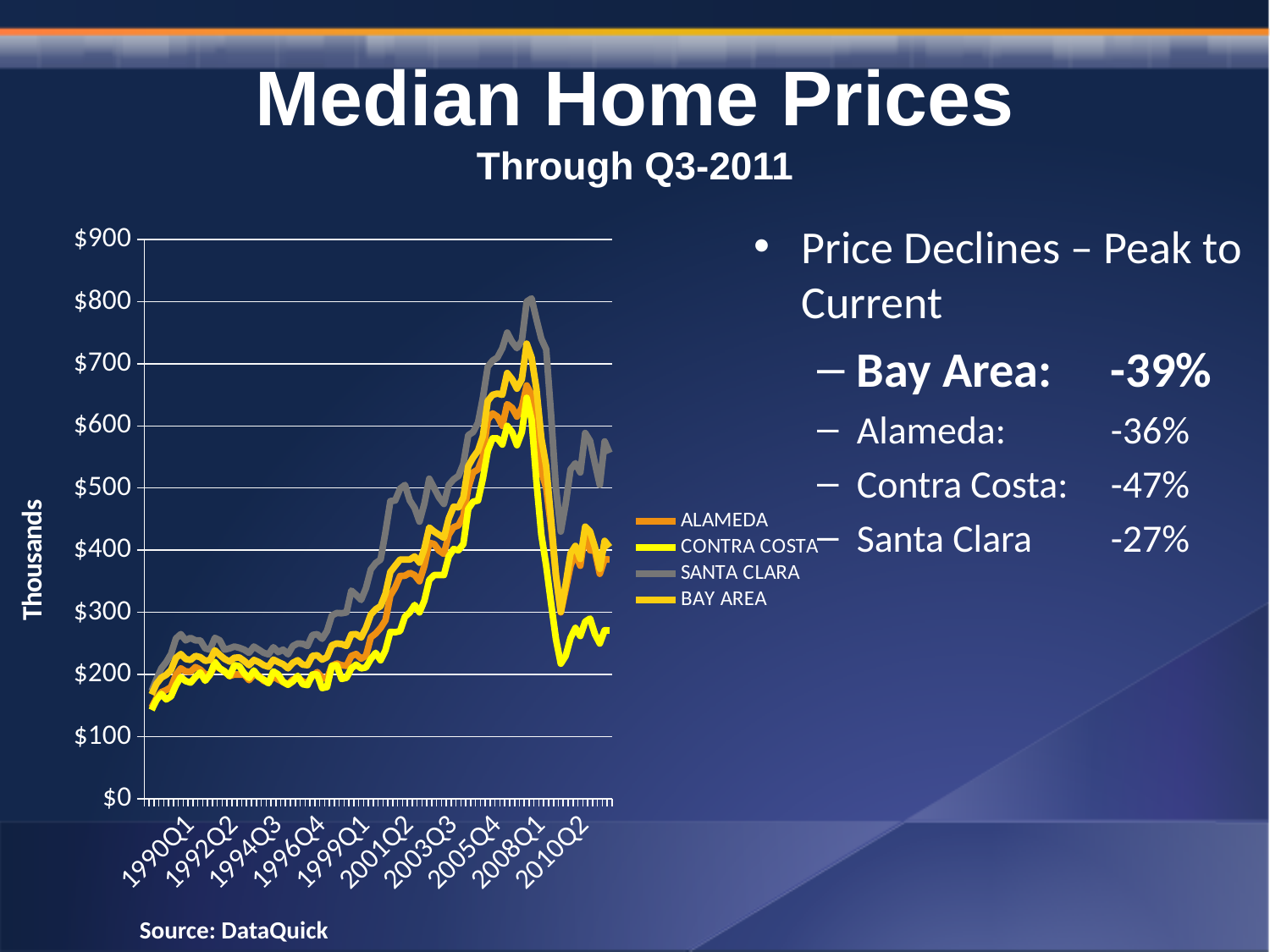
How many series does the chart's legend list? 4 Is the value of the SANTA CLARA series at the right end of the chart greater or less than $500? greater Which series has the lowest value at the right end of the chart? CONTRA COSTA Is the peak value of the SANTA CLARA series greater or less than $700? greater Is the value of the CONTRA COSTA series at the right end of the chart greater or less than $300? less Do the median home prices rise or fall between 1996Q4 and 2008Q1? rise Which series reaches the highest peak on the chart? SANTA CLARA Do the median home prices rise or fall between 2008Q1 and 2010Q2? fall At the peak around 2008, is the SANTA CLARA series or the CONTRA COSTA series higher? SANTA CLARA What kind of chart is shown on the slide? line chart What is the label on the chart's vertical axis? Thousands